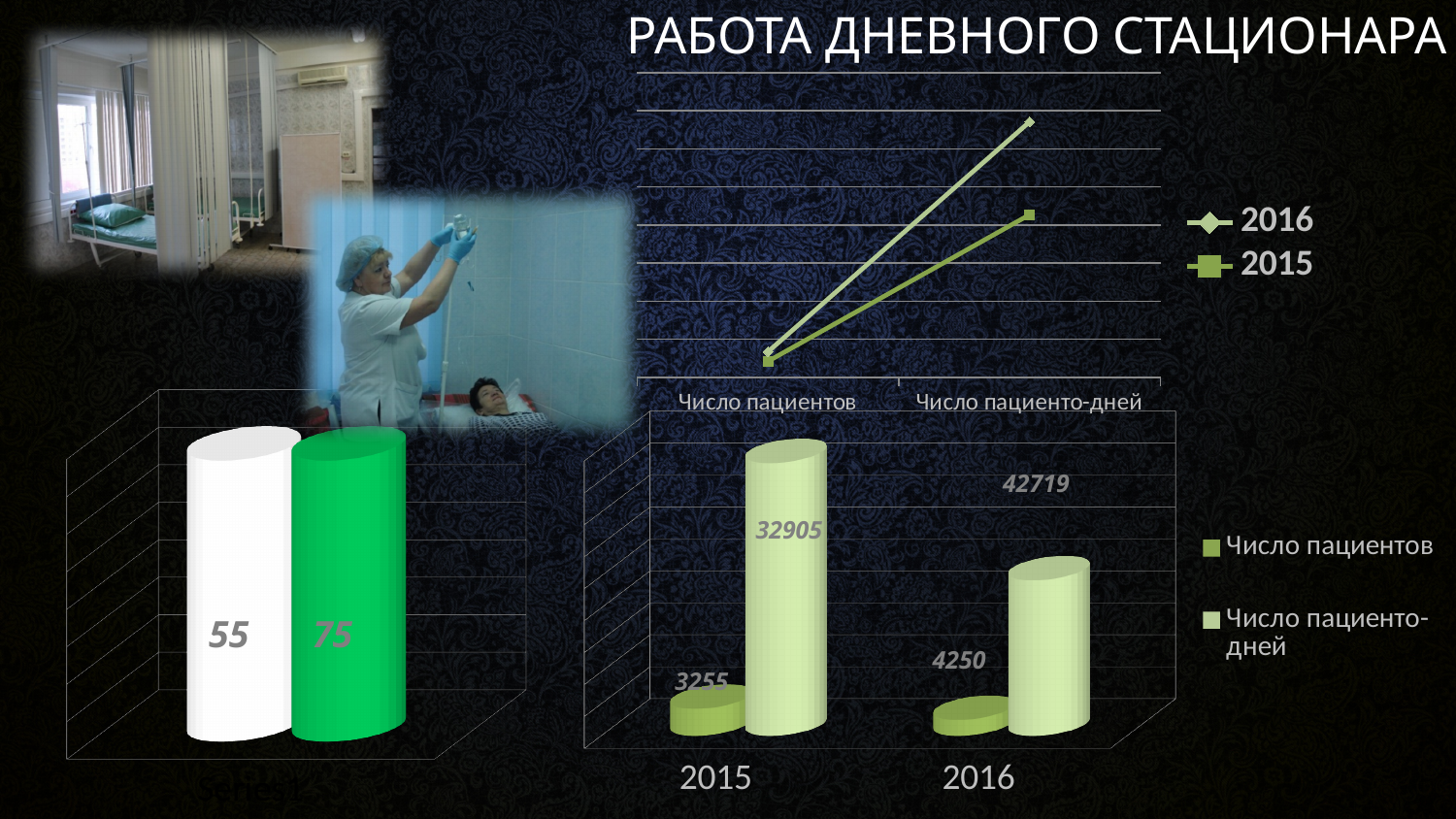
In the bottom-right bar chart, what is the value of Число пациенто-дней for 2015? 32905 In the bottom-right bar chart, what is the value of Число пациентов for 2015? 3255 In the bottom-right bar chart, what is the difference between Число пациентов in 2016 and in 2015? 995 In the bottom-right bar chart, what is the value of Число пациенто-дней for 2016? 42719 In the top-right line chart, how many series does the legend list? 2 In the bottom-right bar chart, what is the difference between Число пациенто-дней in 2016 and in 2015? 9814 In the bottom-left bar chart, what are the values shown on the two bars? 55 and 75 In the bottom-left bar chart, what is the difference between the green bar and the white bar? 20 In the bottom-right bar chart, what is the value of Число пациентов for 2016? 4250 What type of chart is shown at the top right of the slide? Line chart In the bottom-right bar chart, how many series does the legend list? 2